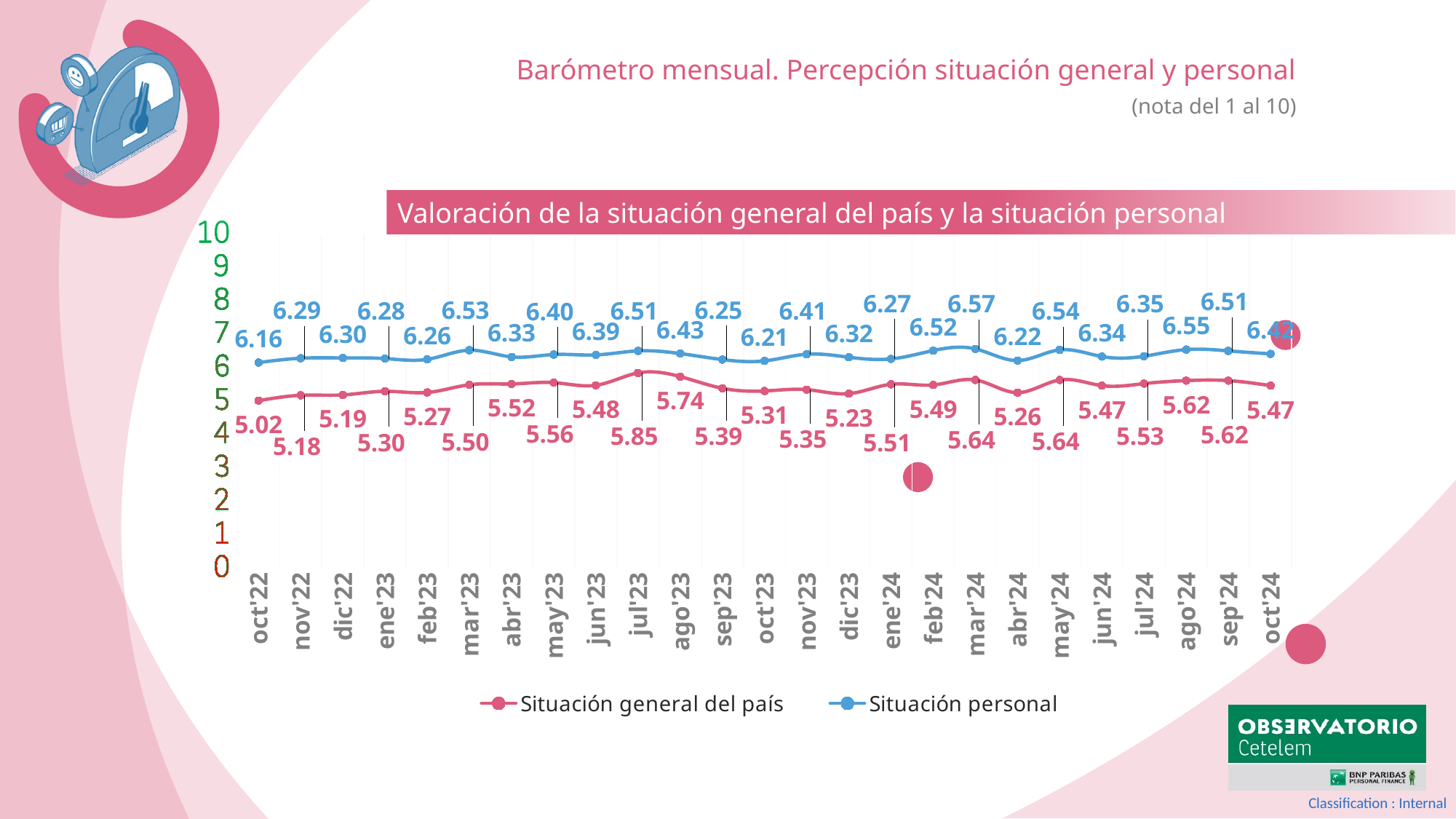
In which month does 'Situación general del país' reach its lowest value? oct'22 How many months are plotted along the x axis? 25 What is the difference between 'Situación personal' and 'Situación general del país' in jul'23? 0.66 What is the value of 'Situación general del país' in jul'23? 5.85 What is the title of the chart? Valoración de la situación general del país y la situación personal What is the value of 'Situación personal' in mar'23? 6.53 How many series does the legend list? 2 In which month does 'Situación personal' reach its highest value? mar'24 What is the value of 'Situación general del país' in oct'22? 5.02 What type of chart is shown on the slide? Line chart Is the value of 'Situación general del país' in sep'24 greater or less than 6? less Which is larger in ene'24: 'Situación personal' or 'Situación general del país'? Situación personal